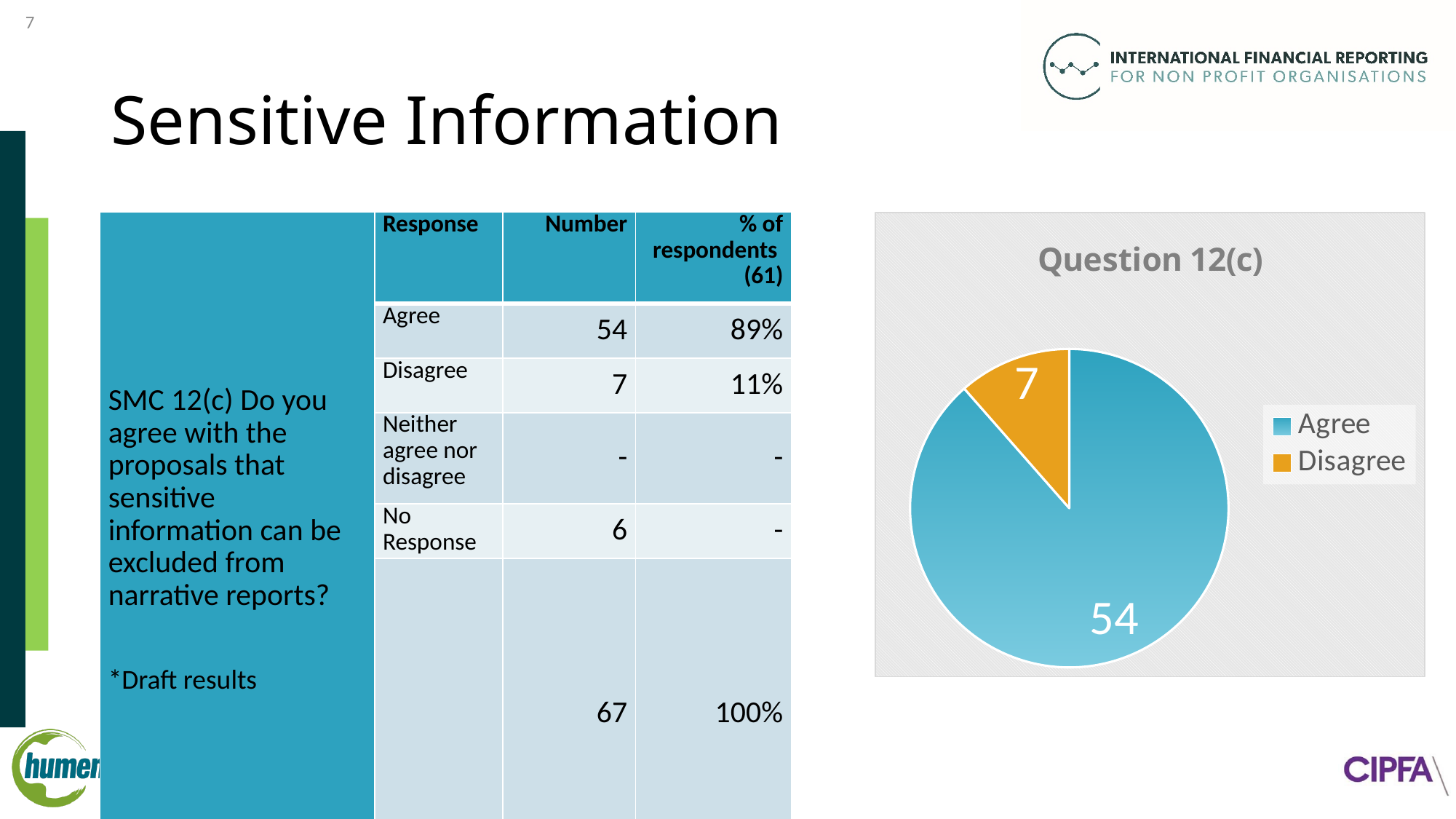
What colour is the Disagree slice in the pie chart? orange What type of chart is shown on the slide? pie chart What is the title of the chart? Question 12(c) What is the value for Disagree in the pie chart? 7 What is the difference between the Agree and Disagree values in the pie chart? 47 What is the total of the values shown in the pie chart? 61 Which category has the smallest slice in the pie chart? Disagree Which is larger in the pie chart, Agree or Disagree? Agree How many entries does the chart legend list? 2 How many slices does the pie chart have? 2 Which category has the largest slice in the pie chart? Agree What is the value for Agree in the pie chart? 54